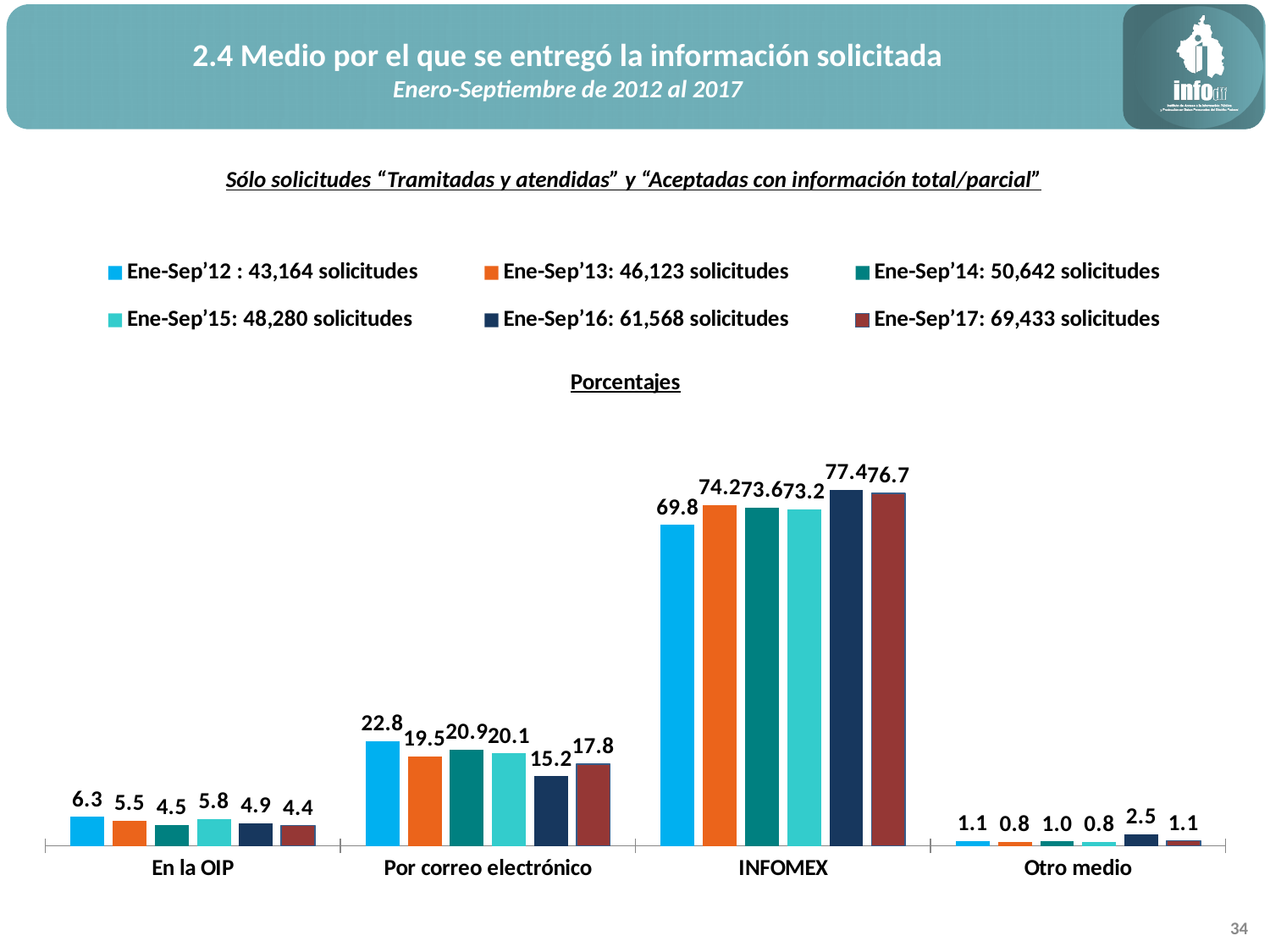
How many series does the legend list? 6 What is the difference between the Ene-Sep'17 and Ene-Sep'12 values for INFOMEX? 6.9 Which series has the lowest value for Por correo electrónico? Ene-Sep'16 What is the value for En la OIP in the Ene-Sep'14 series? 4.5 What is the value for Otro medio in the Ene-Sep'16 series? 2.5 What is the value for Por correo electrónico in the Ene-Sep'12 series? 22.8 According to the legend, how many solicitudes does the Ene-Sep'17 series represent? 69,433 solicitudes How many categories are shown on the x axis? 4 What is the value for INFOMEX in the Ene-Sep'17 series? 76.7 Which is larger for En la OIP: the Ene-Sep'13 value or the Ene-Sep'15 value? Ene-Sep'15 What kind of chart is shown on the slide? Bar chart Which category has the highest value in the Ene-Sep'16 series? INFOMEX